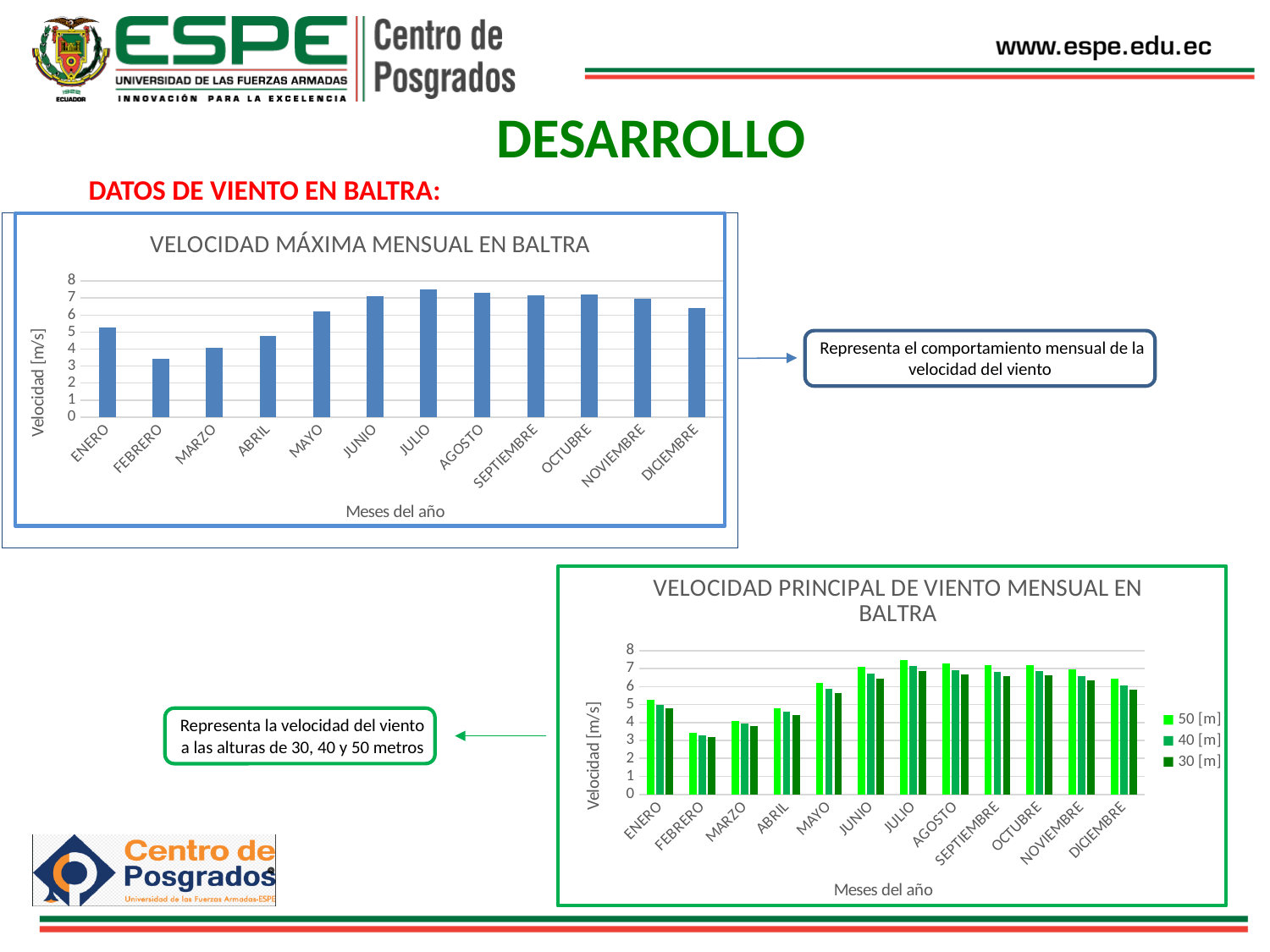
In the chart titled VELOCIDAD PRINCIPAL DE VIENTO MENSUAL EN BALTRA, is the 30 [m] value for FEBRERO greater or less than 4? less In the chart titled VELOCIDAD PRINCIPAL DE VIENTO MENSUAL EN BALTRA, what is the label of the y axis? Velocidad [m/s] In the chart titled VELOCIDAD MÁXIMA MENSUAL EN BALTRA, is the value for JULIO greater or less than 7? greater What kind of chart is the one titled VELOCIDAD PRINCIPAL DE VIENTO MENSUAL EN BALTRA? bar chart In the chart titled VELOCIDAD PRINCIPAL DE VIENTO MENSUAL EN BALTRA, how many series does the legend list? 3 In the chart titled VELOCIDAD MÁXIMA MENSUAL EN BALTRA, which is larger, the value for MAYO or the value for FEBRERO? MAYO In the chart titled VELOCIDAD MÁXIMA MENSUAL EN BALTRA, is the value for FEBRERO greater or less than 4? less In the chart titled VELOCIDAD MÁXIMA MENSUAL EN BALTRA, which month has the highest value? JULIO In the chart titled VELOCIDAD MÁXIMA MENSUAL EN BALTRA, which month has the lowest value? FEBRERO In the chart titled VELOCIDAD MÁXIMA MENSUAL EN BALTRA, how many months are plotted on the x axis? 12 In the chart titled VELOCIDAD MÁXIMA MENSUAL EN BALTRA, do the values rise or fall from FEBRERO to JULIO? rise